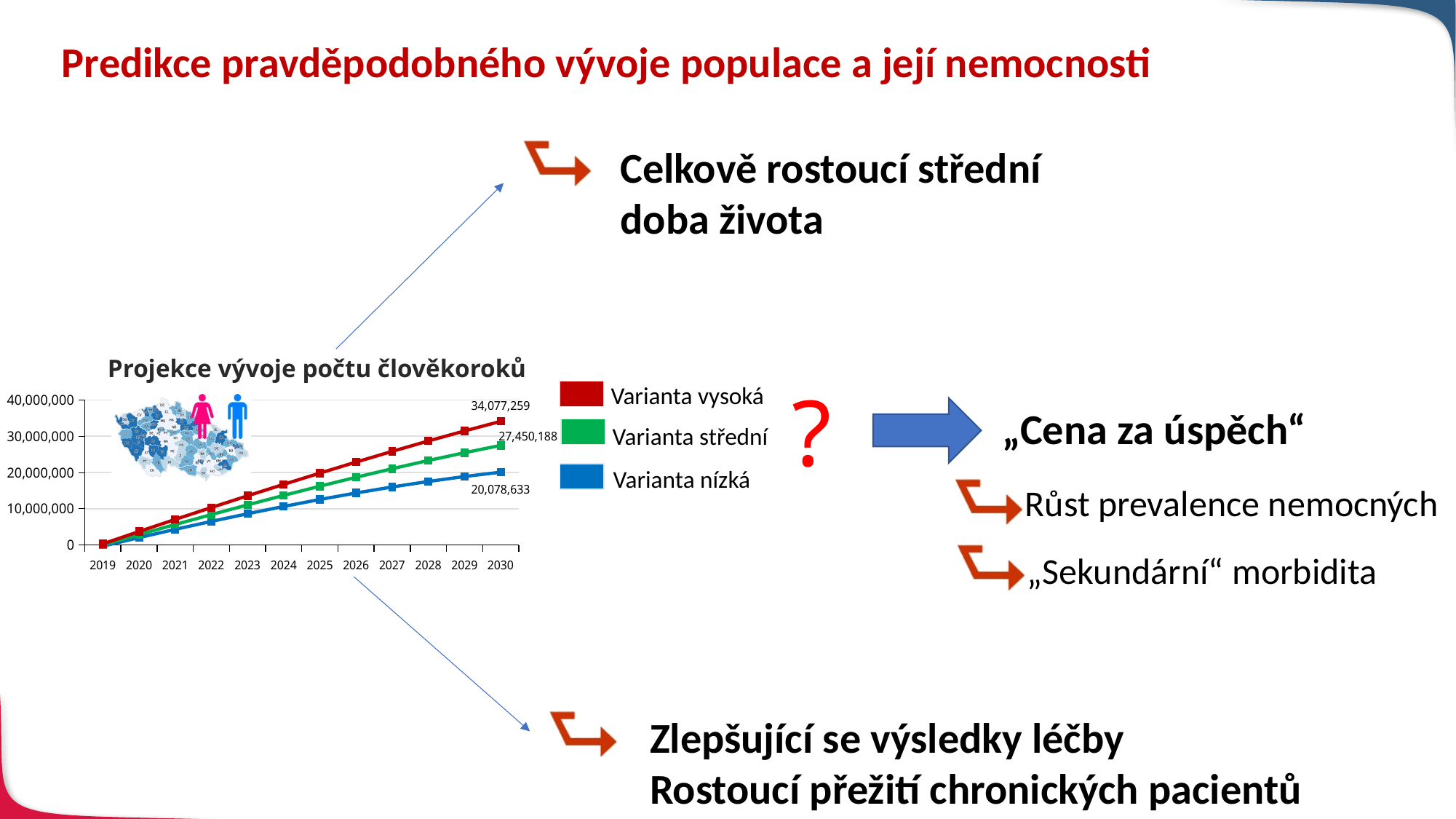
Which series has the lowest value in 2030? Varianta nízká What is the value of Varianta vysoká in 2030? 34,077,259 Which series has the highest value in 2030? Varianta vysoká Do the values of Varianta střední rise or fall from 2019 to 2030? rise How many years are plotted along the x axis of the chart? 12 What is the value of Varianta střední in 2030? 27,450,188 How many series does the chart legend list? 3 What is the difference between Varianta vysoká and Varianta nízká in 2030? 13,998,626 What is the value of Varianta nízká in 2030? 20,078,633 What is the title of the chart? Projekce vývoje počtu člověkoroků What kind of chart is shown on the slide? line chart Is the value for Varianta vysoká in 2027 greater or less than 20,000,000? greater